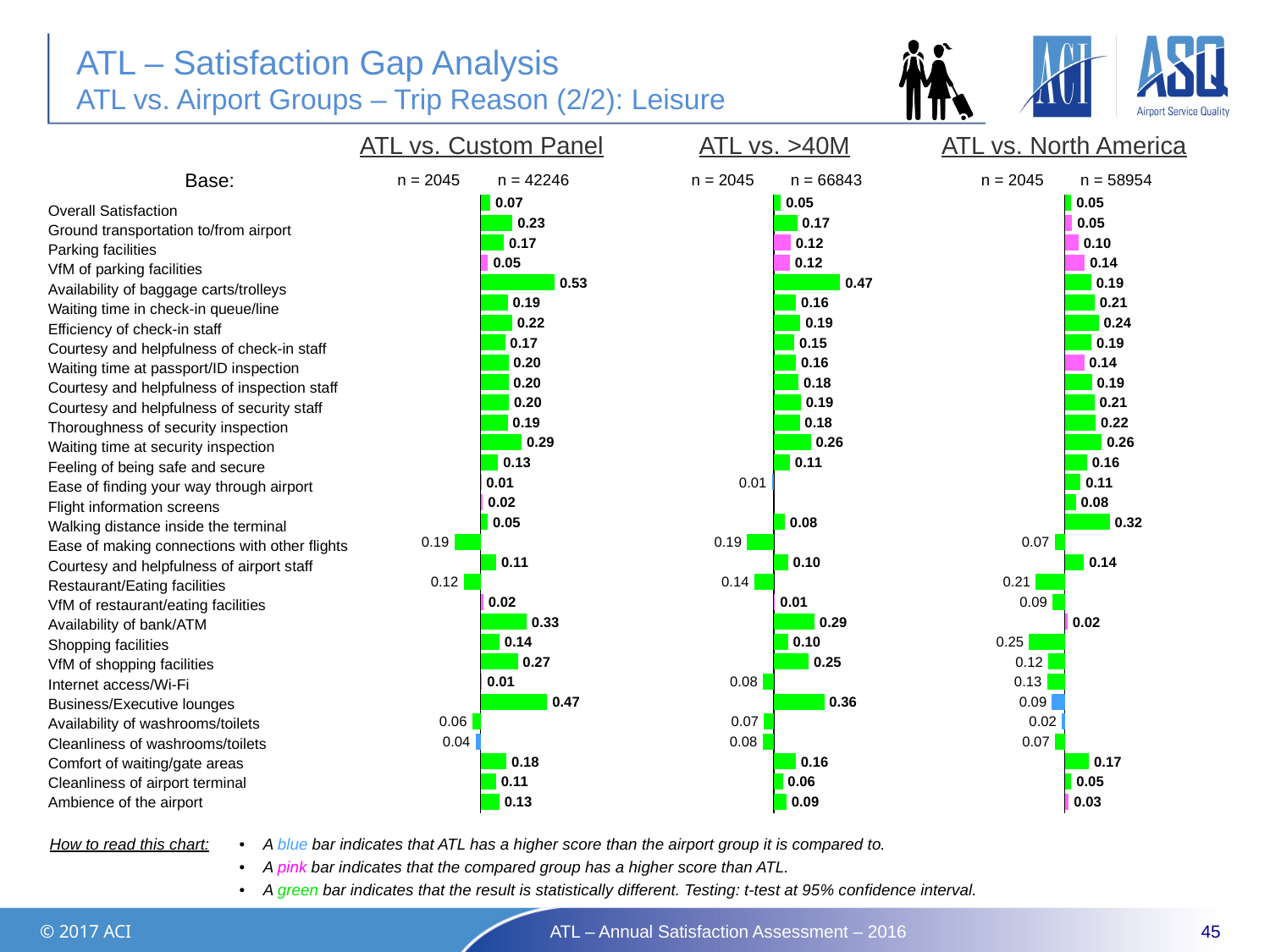
In the ATL vs. >40M chart, what is the value for Business/Executive lounges? 0.36 In the ATL vs. Custom Panel chart, which category has the largest value? Availability of baggage carts/trolleys In the ATL vs. Custom Panel chart, what is the difference between the values for Availability of bank/ATM and Shopping facilities? 0.19 What is the base (n) shown for the Custom Panel group in the ATL vs. Custom Panel chart? n = 42246 In the ATL vs. North America chart, which category has the largest value? Walking distance inside the terminal In the ATL vs. >40M chart, what is the value for Availability of baggage carts/trolleys? 0.47 In the ATL vs. North America chart, what is the value for Walking distance inside the terminal? 0.32 In the ATL vs. Custom Panel chart, what is the value for Overall Satisfaction? 0.07 In the ATL vs. North America chart, what is the value for Shopping facilities? 0.25 In the ATL vs. Custom Panel chart, what is the value for Availability of baggage carts/trolleys? 0.53 What kind of chart is used for the ATL vs. Custom Panel comparison? Bar chart In the ATL vs. >40M chart, which is larger: the value for Waiting time at security inspection or the value for Availability of bank/ATM? Availability of bank/ATM